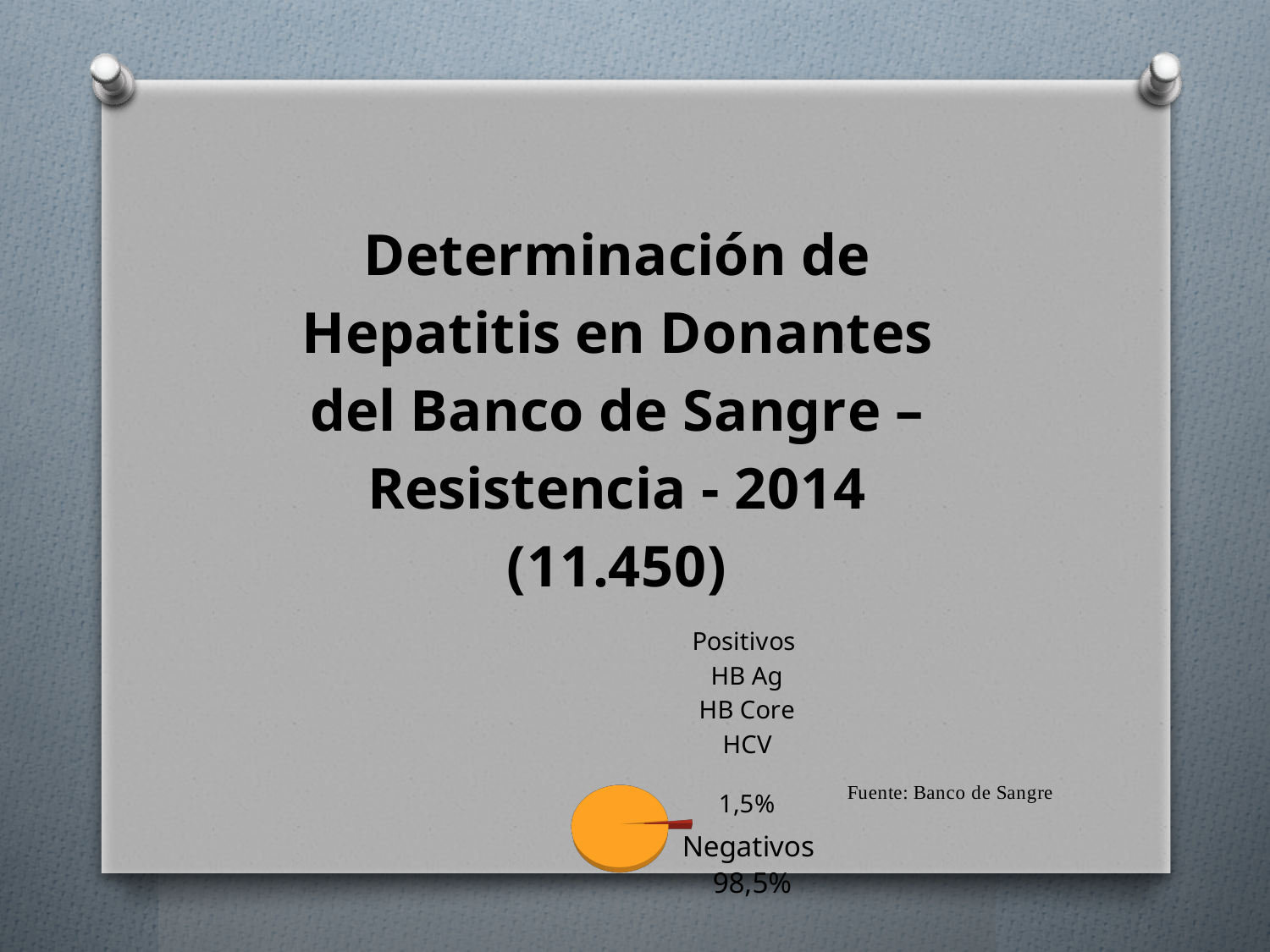
What percentage of donors were Positivos? 1,5% What kind of chart is shown on the slide? Pie chart What share of the pie does the Negativos slice represent? 98,5% What is the difference in percentage points between Negativos and Positivos? 97 percentage points What percentage of donors were Negativos? 98,5% Which hepatitis markers are listed under the Positivos slice? HB Ag, HB Core, HCV What is the source cited for the chart data? Banco de Sangre Which slice of the pie is the largest? Negativos How many slices does the pie chart have? 2 Which is larger, the Positivos share or the Negativos share? Negativos Which slice of the pie is the smallest? Positivos